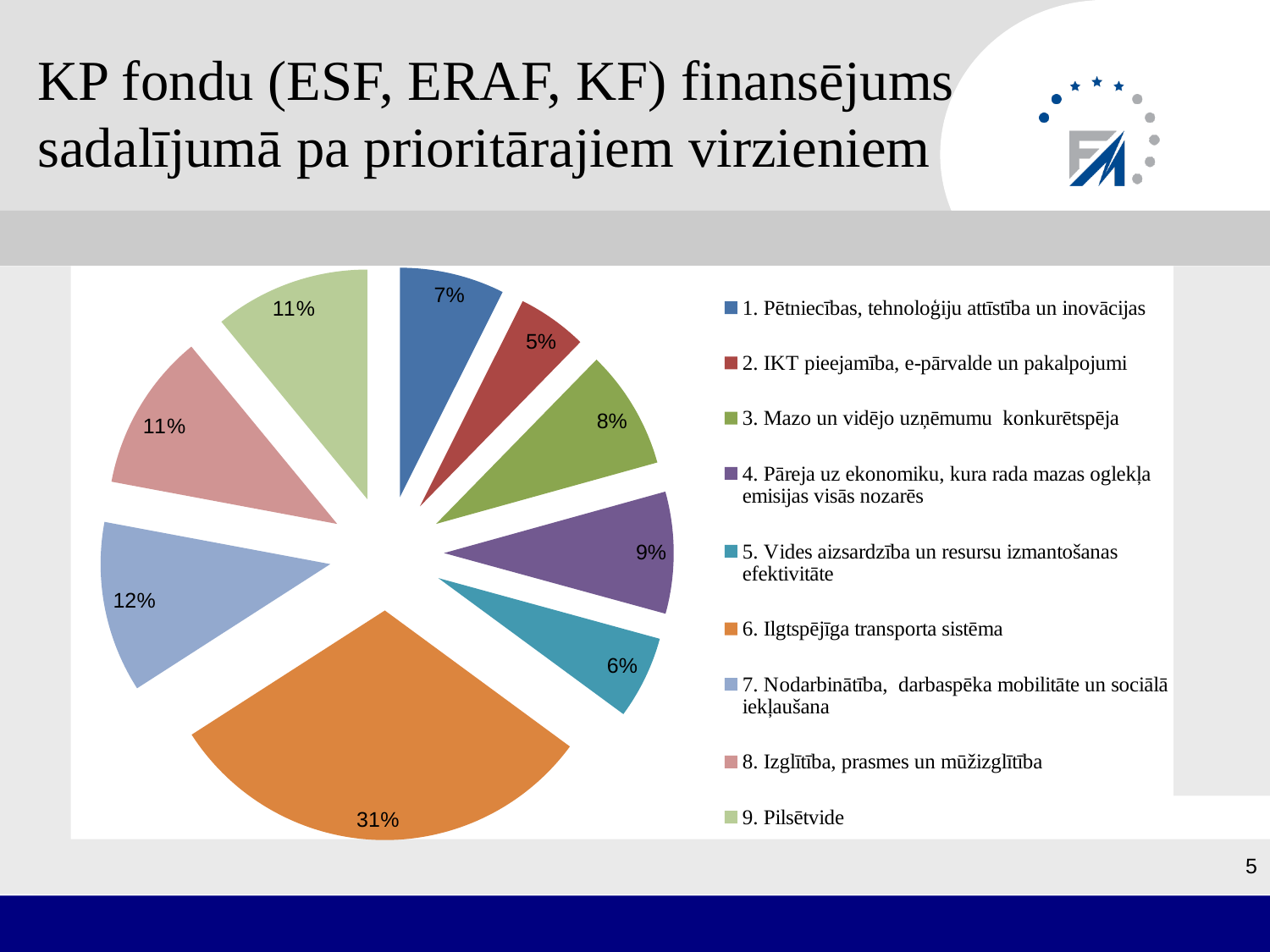
What is the value shown for "4. Pāreja uz ekonomiku, kura rada mazas oglekļa emisijas visās nozarēs"? 9% What is the value shown for "7. Nodarbinātība, darbaspēka mobilitāte un sociālā iekļaušana"? 12% What is the difference between the shares of "6. Ilgtspējīga transporta sistēma" and "7. Nodarbinātība, darbaspēka mobilitāte un sociālā iekļaušana"? 19% What share of the pie does "6. Ilgtspējīga transporta sistēma" have? 31% What is the value shown for "1. Pētniecības, tehnoloģiju attīstība un inovācijas"? 7% Which category has the smallest slice of the pie? 2. IKT pieejamība, e-pārvalde un pakalpojumi What kind of chart is shown on the slide? pie chart What colour is the slice for "6. Ilgtspējīga transporta sistēma"? orange Which category has the largest slice of the pie? 6. Ilgtspējīga transporta sistēma Which has a larger share: "3. Mazo un vidējo uzņēmumu konkurētspēja" or "5. Vides aizsardzība un resursu izmantošanas efektivitāte"? 3. Mazo un vidējo uzņēmumu konkurētspēja What is the value shown for "9. Pilsētvide"? 11% How many slices does the pie chart have? 9